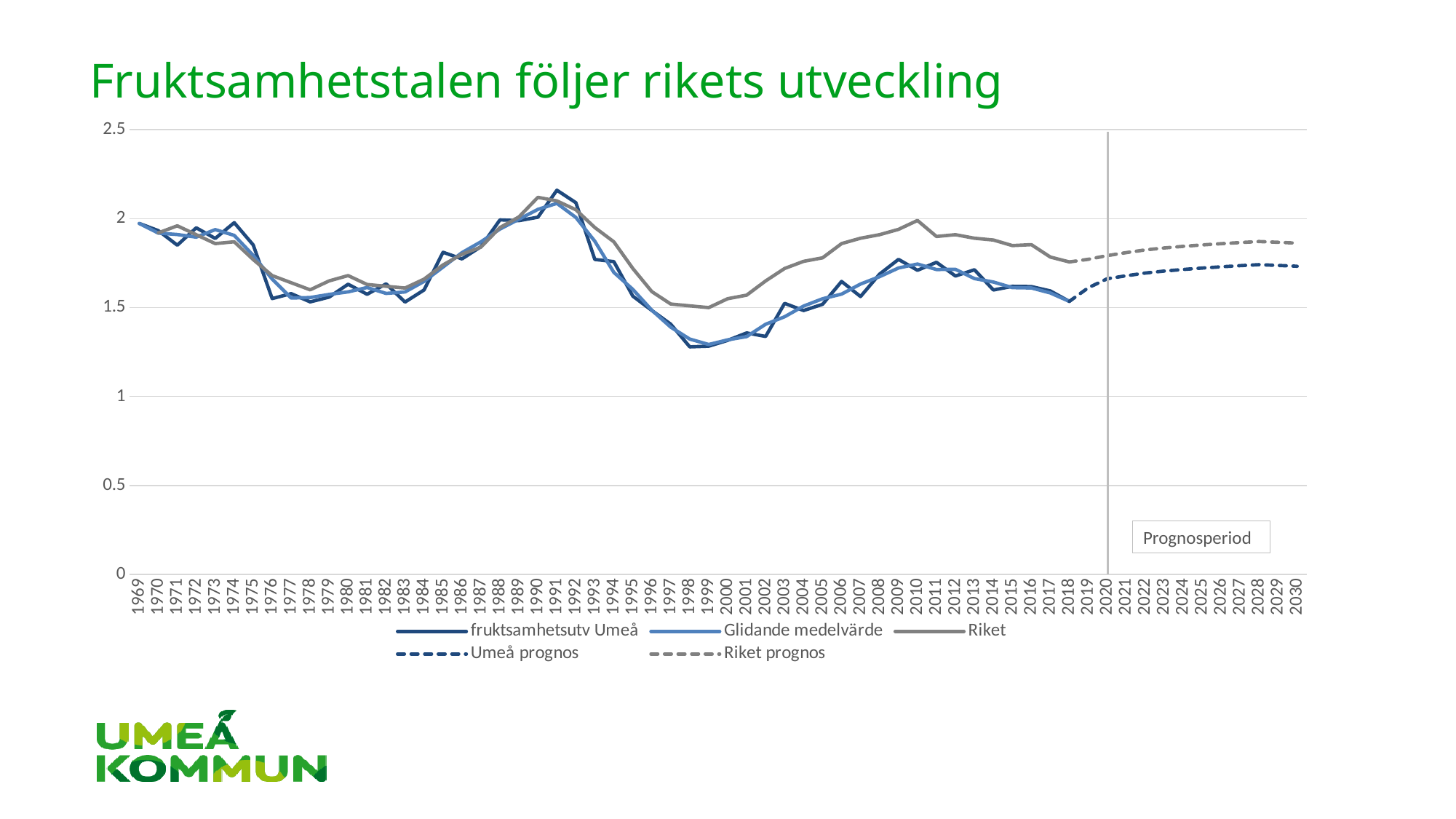
Is the value for fruktsamhetsutv Umeå in 1991 greater or less than 2? greater Does the Umeå prognos series rise or fall from 2020 to 2030? rise Is the value for fruktsamhetsutv Umeå in 1998 greater or less than 1.5? less In which year does the fruktsamhetsutv Umeå series reach its highest value? 1991 What is the title of the chart? Fruktsamhetstalen följer rikets utveckling What kind of chart is shown on the slide? line chart What label is shown in the box to the right of the vertical line in the chart? Prognosperiod How many series does the legend list? 5 Is the value for Umeå prognos in 2030 greater or less than 2? less In 2017, which series has the higher value, Riket or fruktsamhetsutv Umeå? Riket